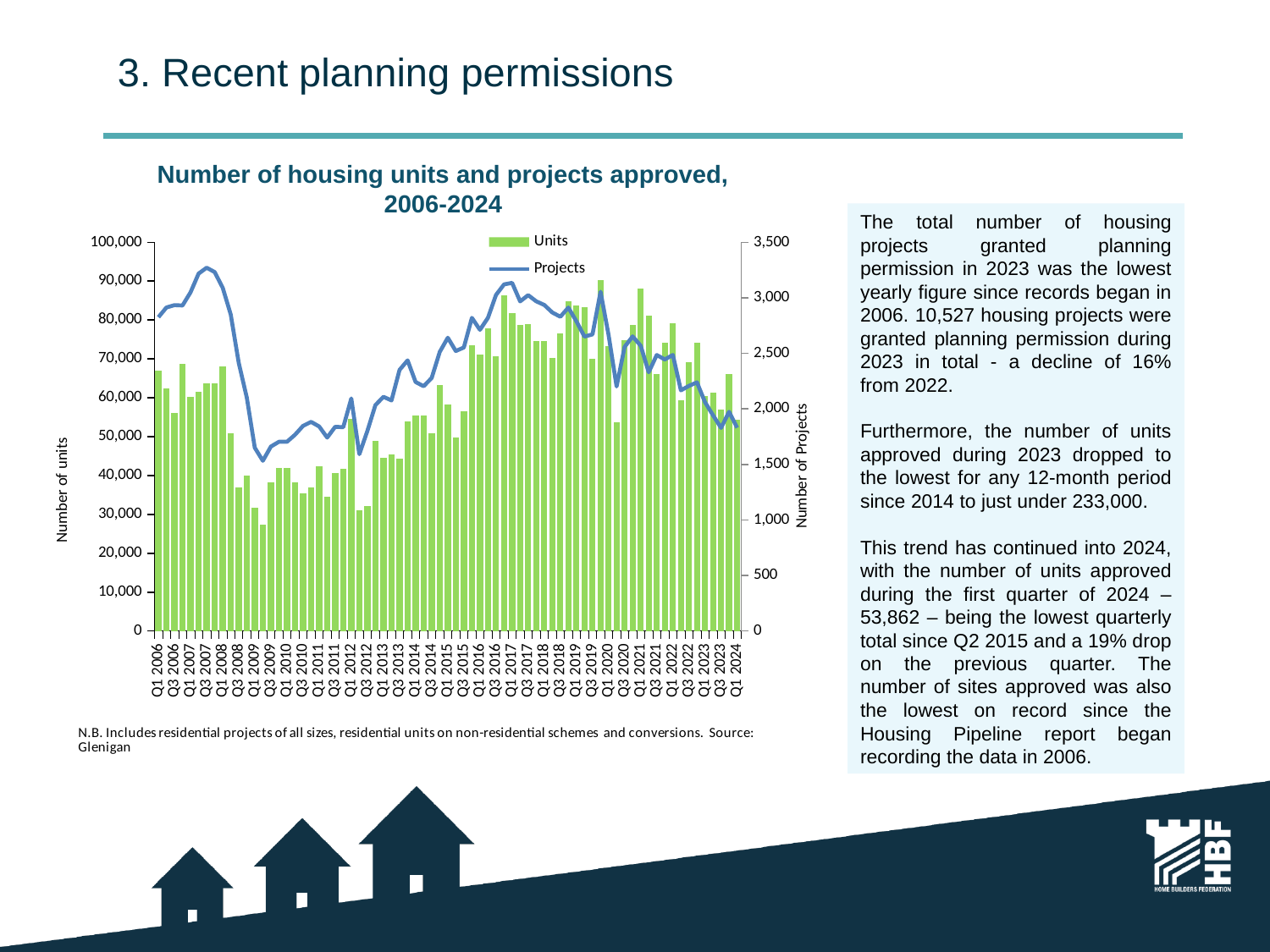
Which quarter has the lowest number of units approved? Q2 2009 What kind of chart is shown on the slide? A combined bar and line chart What is the title of the chart? Number of housing units and projects approved, 2006-2024 Is the number of units approved in Q1 2020 greater or less than 80,000? less Do the units approved rise or fall between Q1 2006 and Q1 2009? fall Is the number of units approved in Q1 2006 greater or less than 60,000? greater Which quarter has more units approved, Q1 2006 or Q1 2009? Q1 2006 What are the two series named in the chart legend? Units and Projects Is the number of projects in Q1 2024 greater or less than 2,000? less How many series does the chart legend list? 2